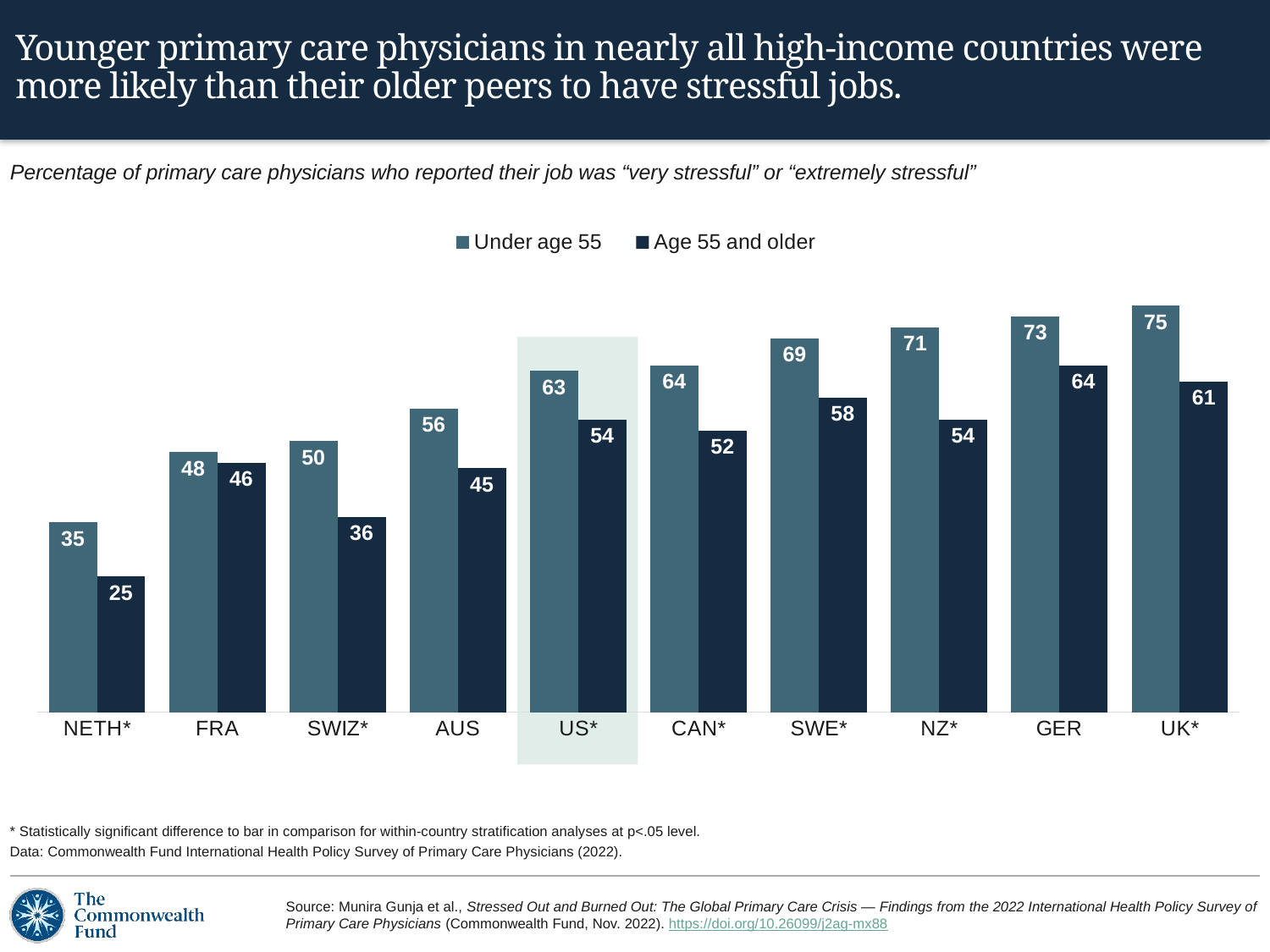
What is the value for Age 55 and older in NETH*? 25 Which country's bars are highlighted with a shaded background? US* Do the Under age 55 values rise or fall from NETH* to UK* along the x axis? Rise What is the value for Under age 55 in the US*? 63 What kind of chart is shown on the slide? Bar chart How many series does the legend list? 2 Which is larger in SWIZ*: the Under age 55 value or the Age 55 and older value? Under age 55 How many countries are shown on the x axis? 10 Which country has the lowest value for Age 55 and older? NETH* Which country has the highest value for Under age 55? UK* What is the value for Age 55 and older in GER? 64 What is the difference between the Under age 55 and Age 55 and older values for NZ*? 17